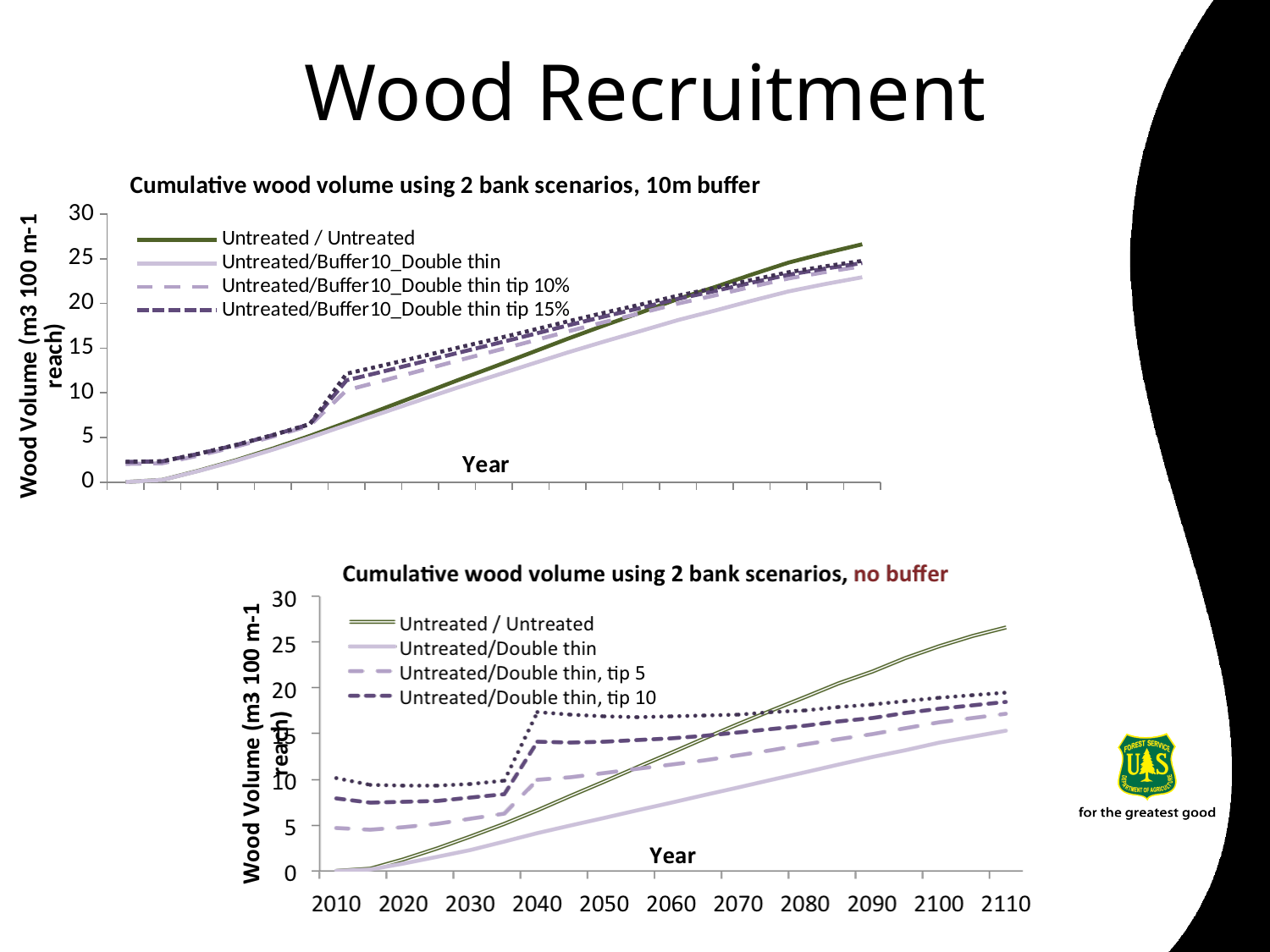
In the bottom chart ('no buffer'), at 2110, which is larger: Untreated / Untreated or Untreated/Double thin? Untreated / Untreated In the bottom chart ('no buffer'), which series has the lowest value at 2110? Untreated/Double thin In the top chart ('10m buffer'), do the values for Untreated / Untreated rise or fall along the x axis? rise In the bottom chart ('no buffer'), is the value for Untreated/Double thin, tip 10 at 2010 greater or less than 10? less In the bottom chart ('no buffer'), is the value for Untreated/Double thin at 2110 greater or less than 20? less How many series does the legend of the top chart, 'Cumulative wood volume using 2 bank scenarios, 10m buffer', list? 4 What is the x-axis label of the bottom chart ('no buffer')? Year In the bottom chart ('no buffer'), which series has the highest value at 2110? Untreated / Untreated What kind of chart is the top chart, 'Cumulative wood volume using 2 bank scenarios, 10m buffer'? line chart In the bottom chart ('no buffer'), is the value for Untreated / Untreated at 2110 greater or less than 25? greater How many series does the legend of the bottom chart, 'Cumulative wood volume using 2 bank scenarios, no buffer', list? 4